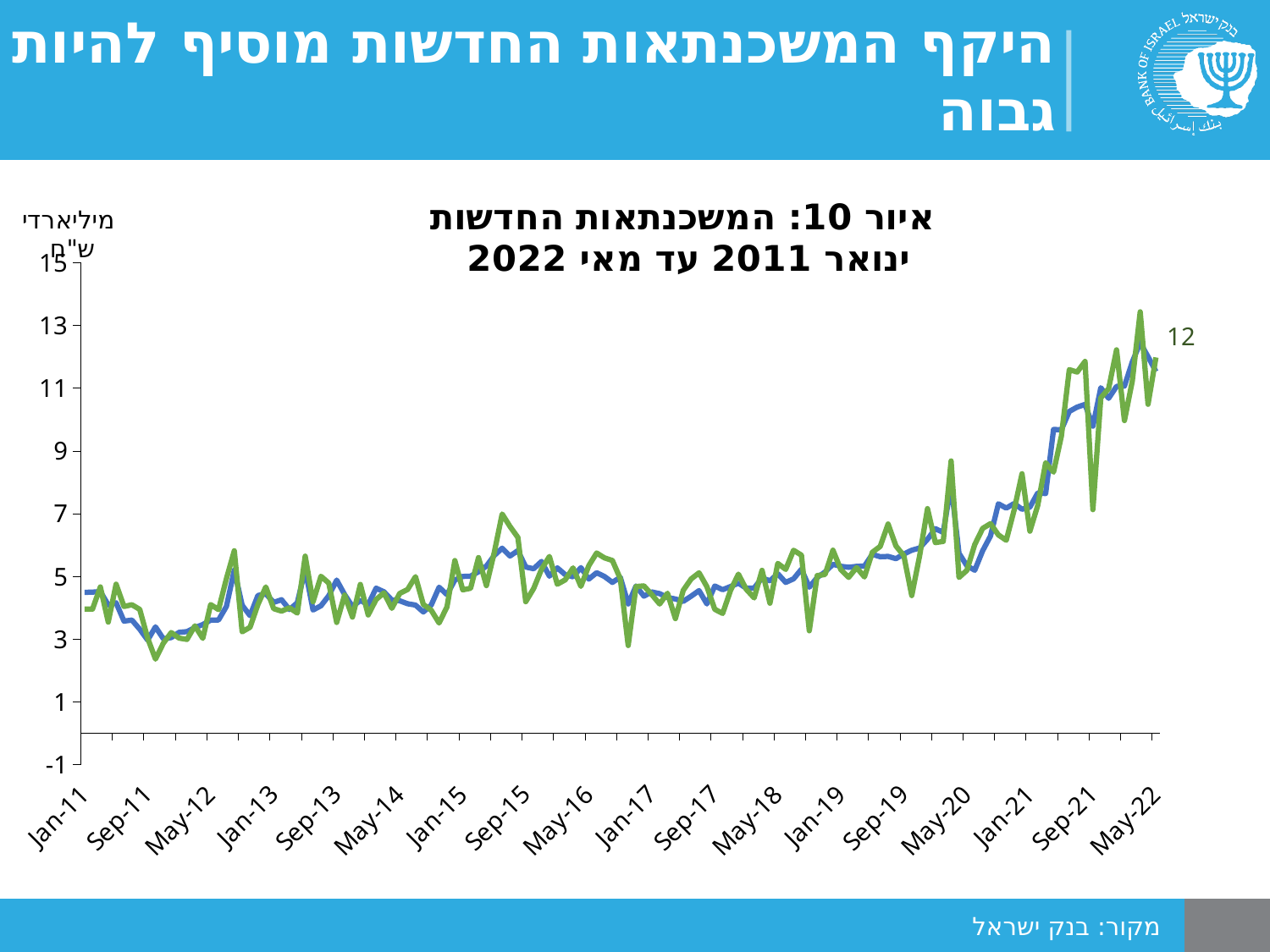
Is the value at May-22 greater or less than 11? greater What is the title of the chart? איור 10: המשכנתאות החדשות ינואר 2011 עד מאי 2022 Is the value at Jan-11 greater or less than 5? less Is the value at Jan-21 greater or less than 5? greater What unit is shown on the y-axis label of the chart? מיליארדי ש"ח How many lines are plotted on the chart? 2 What is the first x-axis label on the chart? Jan-11 What data label is printed at the right end of the chart? 12 What kind of chart is shown on the slide? line chart Which is larger, the value at Jan-11 or the value at May-22? May-22 Overall, do the values rise or fall from Jan-11 to May-22? rise